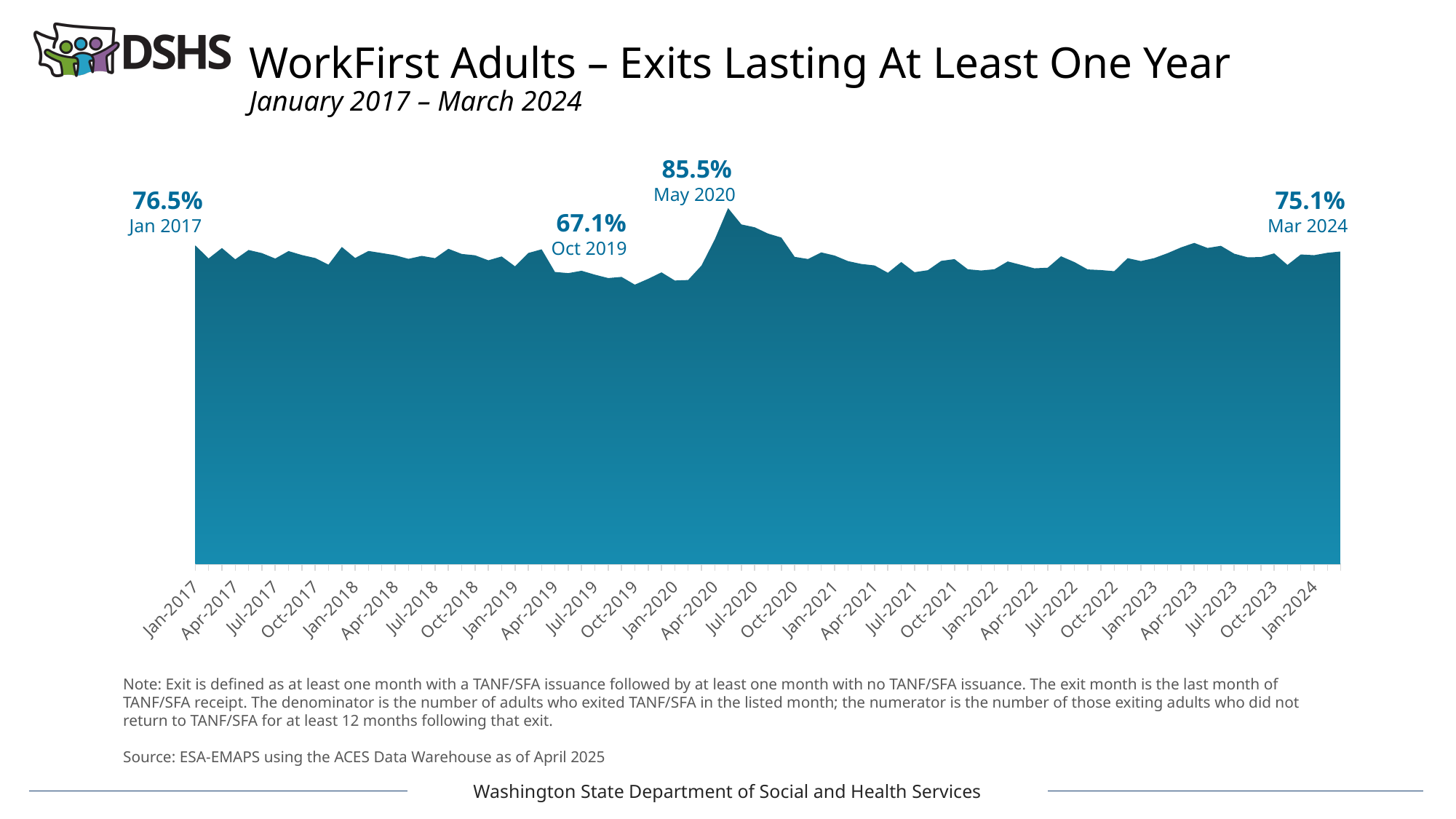
What is the value labeled for Jan 2017? 76.5% What is the value labeled for May 2020? 85.5% Which labeled month has the lowest value? Oct 2019 What is the difference between the Jan 2017 value and the Mar 2024 value? 1.4 percentage points What is the value labeled for Mar 2024? 75.1% What kind of chart is shown on the slide? Area chart Which is larger, the value for Jan 2017 or the value for Mar 2024? Jan 2017 What is the difference between the May 2020 value and the Oct 2019 value? 18.4 percentage points What date range does the chart subtitle give? January 2017 – March 2024 How many data points have printed value labels on the chart? 4 Which labeled month has the highest value? May 2020 What is the value labeled for Oct 2019? 67.1%